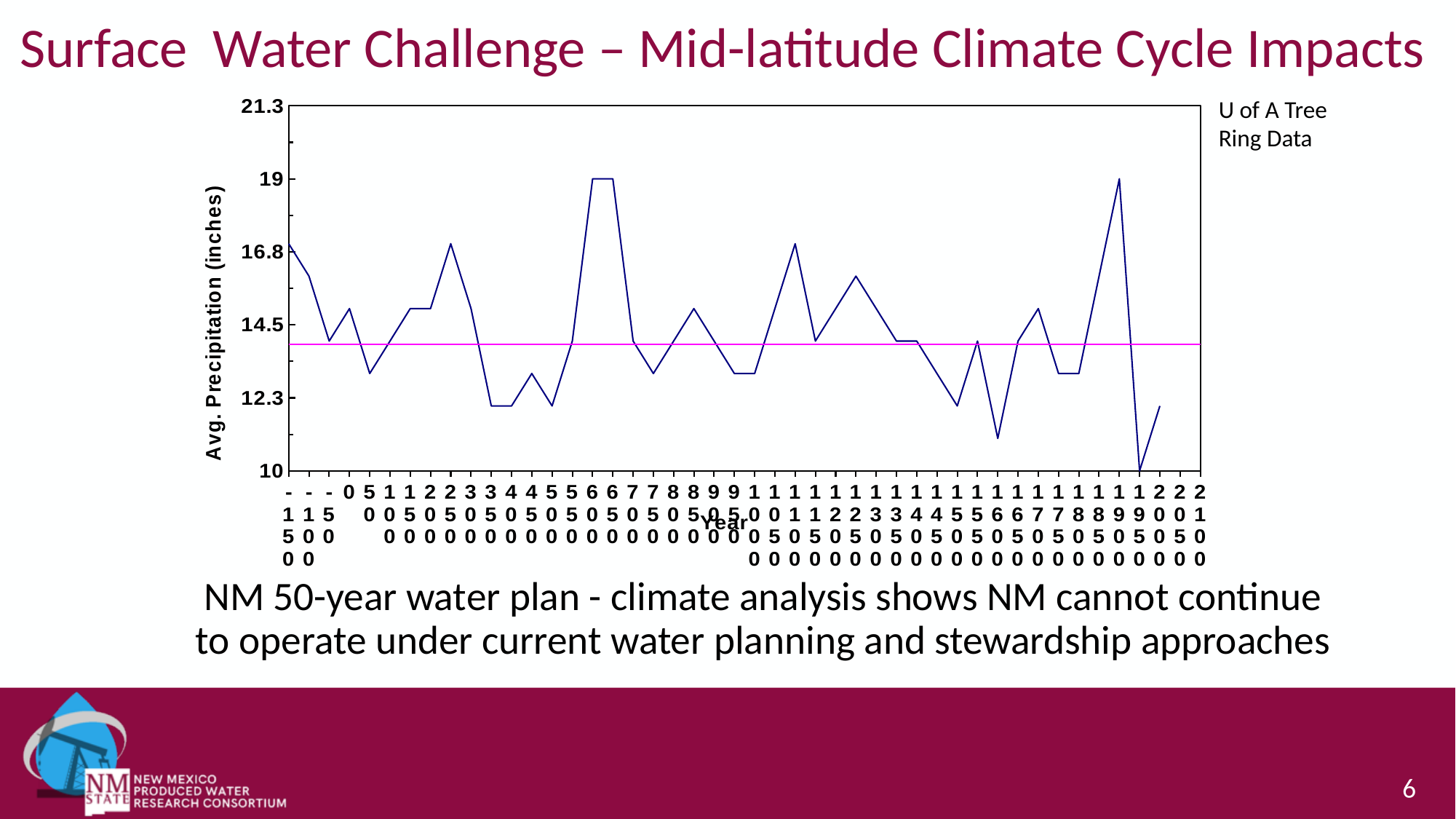
Is the last value of the precipitation line higher or lower than the first value? lower What is the highest value shown on the y-axis scale? 21.3 What data source is noted next to the chart? U of A Tree Ring Data What is the title of the y-axis of the chart? Avg. Precipitation (inches) Is the peak value of the precipitation line greater or less than 16.8? greater Is the lowest value of the precipitation line greater or less than 12.3? less What type of chart is shown on the slide? line chart What is the highest value the precipitation line reaches on the chart? 19 How many times does the precipitation line reach the 19 inch level? 3 What is the lowest value the precipitation line reaches on the chart? 10